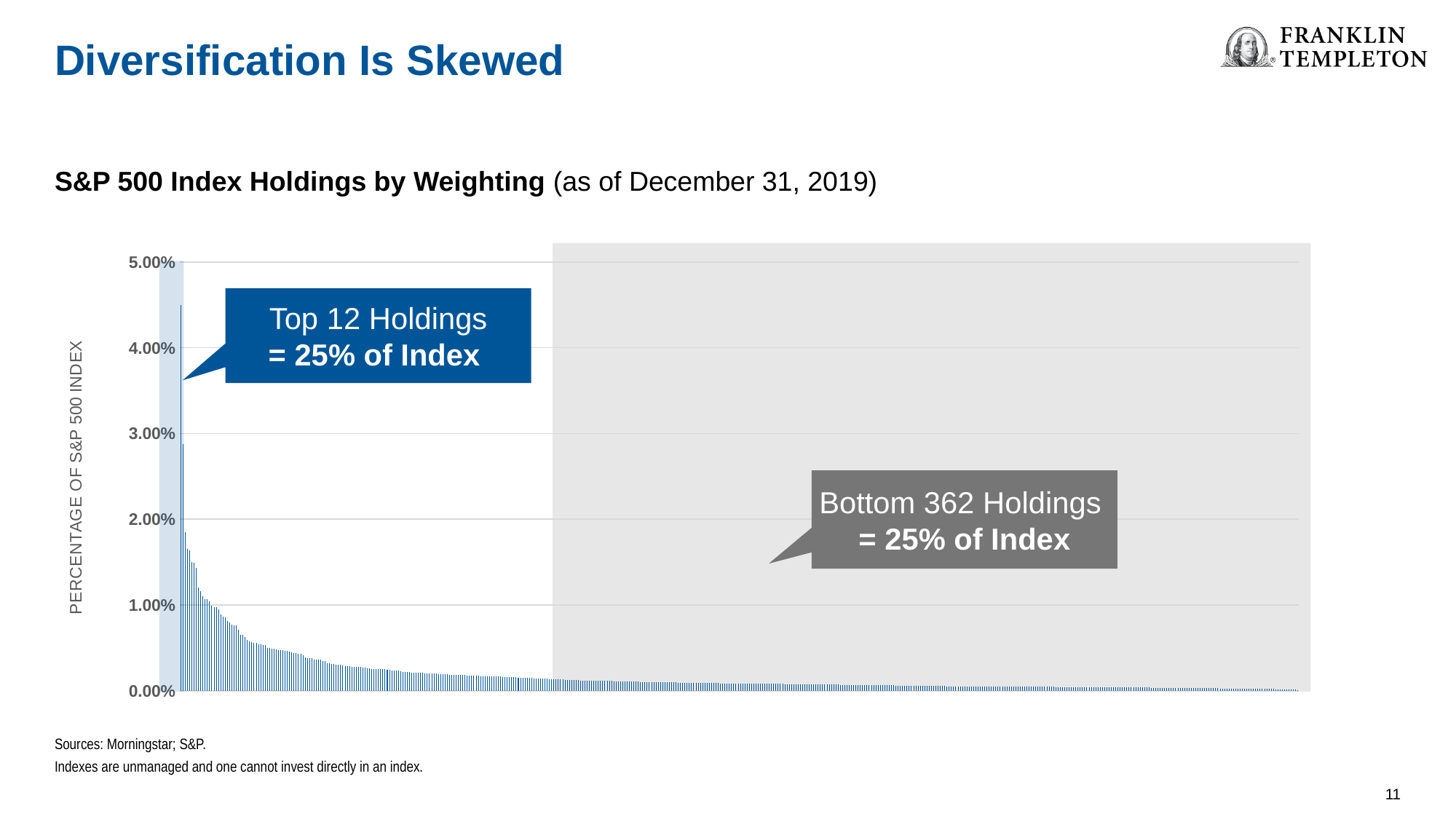
Do the bar values rise or fall moving from left to right along the x axis? fall According to the chart annotation, what share of the index do the bottom 362 holdings represent? 25% of Index According to the chart annotation, what share of the index do the top 12 holdings represent? 25% of Index What is the label on the vertical axis of the chart? PERCENTAGE OF S&P 500 INDEX Is the value of the largest holding greater or less than 5.00%? less Is the value of the largest holding greater or less than 4.00%? greater What kind of chart is shown on the slide? bar chart What is the title of the chart on the slide? S&P 500 Index Holdings by Weighting How many holdings make up the bottom group highlighted in the chart? 362 What is the highest value shown on the vertical axis of the chart? 5.00% How many holdings make up the top group highlighted in the chart? 12